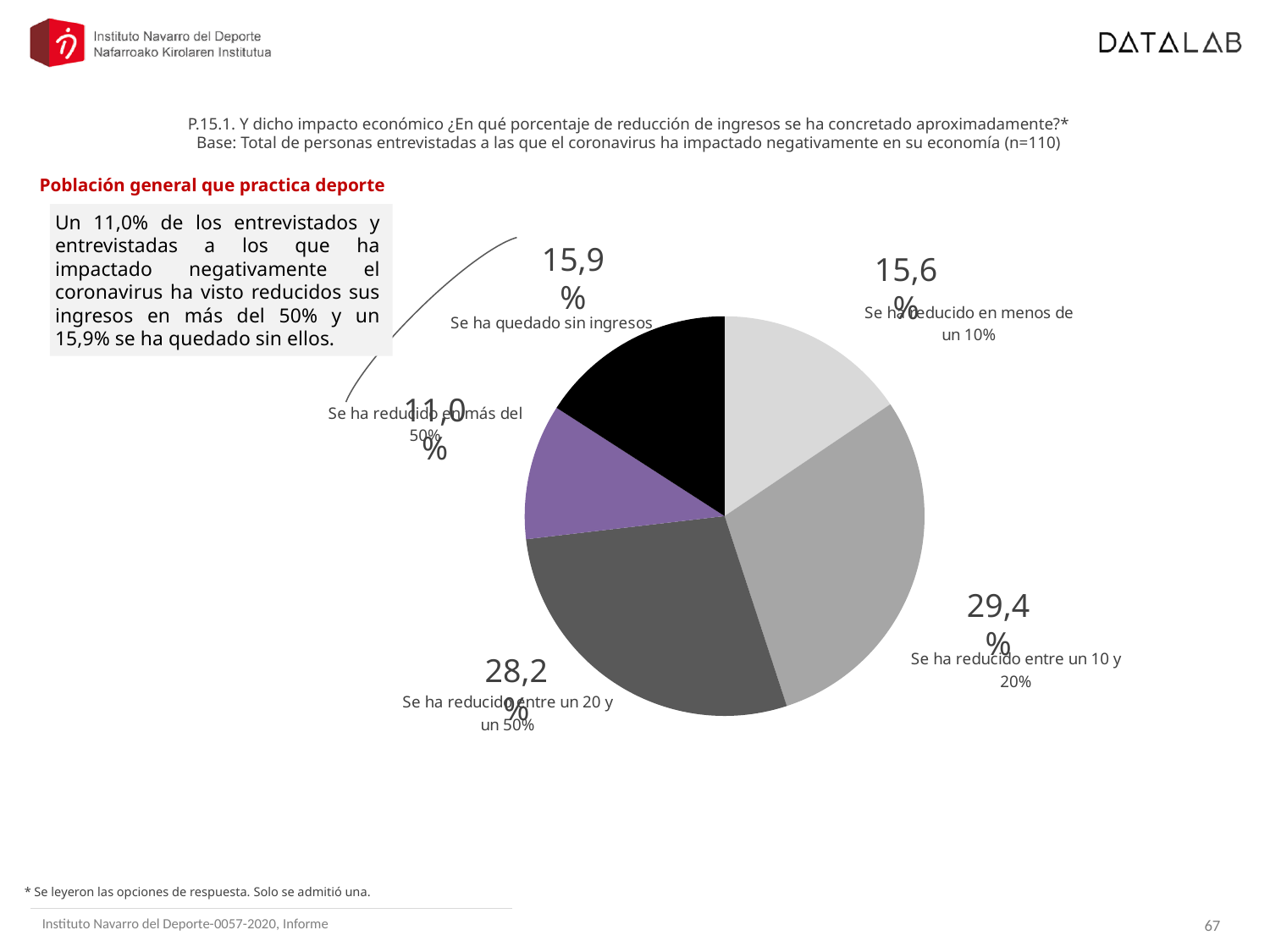
How many categories (slices) does the pie chart have? 5 Which category has the smallest share of the pie? Se ha reducido en más del 50% What type of chart is shown on the slide? Pie chart Which is larger: the share for 'Se ha quedado sin ingresos' or the share for 'Se ha reducido en menos de un 10%'? Se ha quedado sin ingresos Which category has the largest share of the pie? Se ha reducido entre un 10 y 20% What colour is the slice for 'Se ha reducido en más del 50%'? Purple What percentage of respondents said 'Se ha quedado sin ingresos'? 15,9% What percentage of respondents said 'Se ha reducido en menos de un 10%'? 15,6% What is the sample size (n) stated in the base of the chart? n=110 What percentage of respondents said 'Se ha reducido en más del 50%'? 11,0% What percentage of respondents said 'Se ha reducido entre un 10 y 20%'? 29,4% What is the difference in percentage points between 'Se ha reducido entre un 10 y 20%' and 'Se ha reducido entre un 20 y un 50%'? 1,2